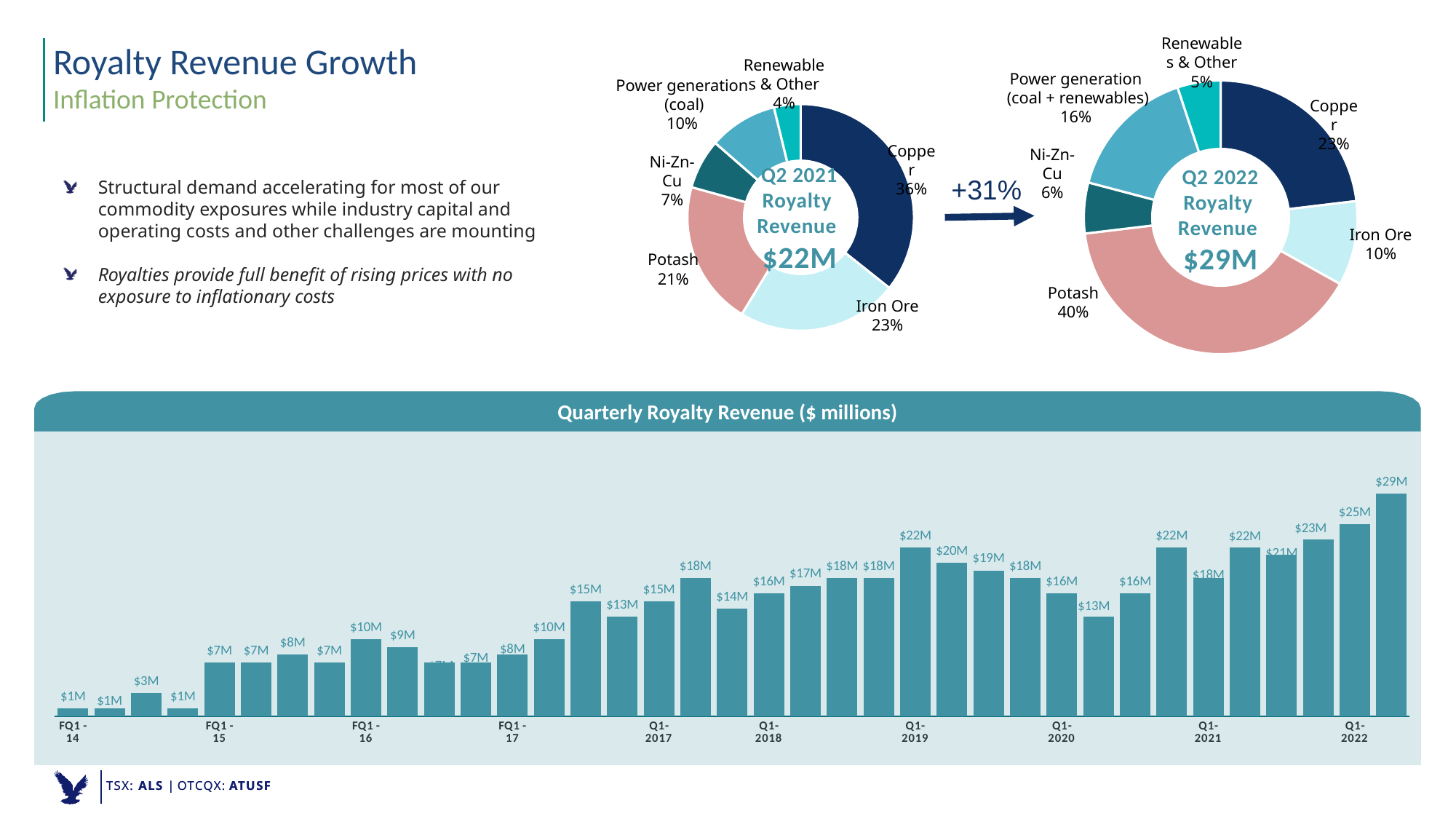
Is Iron Ore's share larger in the Q2 2021 donut chart or the Q2 2022 donut chart? Q2 2021 In the Q2 2022 Royalty Revenue donut chart, which commodity has the largest slice? Potash What total royalty revenue is shown in the centre of the Q2 2021 donut chart? $22M What type of chart is the Quarterly Royalty Revenue chart? Bar chart What growth percentage is shown between the Q2 2021 and Q2 2022 donut charts? +31% In the Q2 2021 Royalty Revenue donut chart, which category has the smallest slice? Renewable & Other In the Quarterly Royalty Revenue chart, what is the value for Q1-2019? $22M In the Quarterly Royalty Revenue chart, what is the highest quarterly value shown? $29M In the Q2 2021 Royalty Revenue donut chart, what share does Copper account for? 36% In the Q2 2022 Royalty Revenue donut chart, what share does Potash account for? 40% By how many percentage points did Potash's share increase from the Q2 2021 donut chart to the Q2 2022 donut chart? 19 percentage points In the Q2 2022 Royalty Revenue donut chart, what share does Ni-Zn-Cu account for? 6%